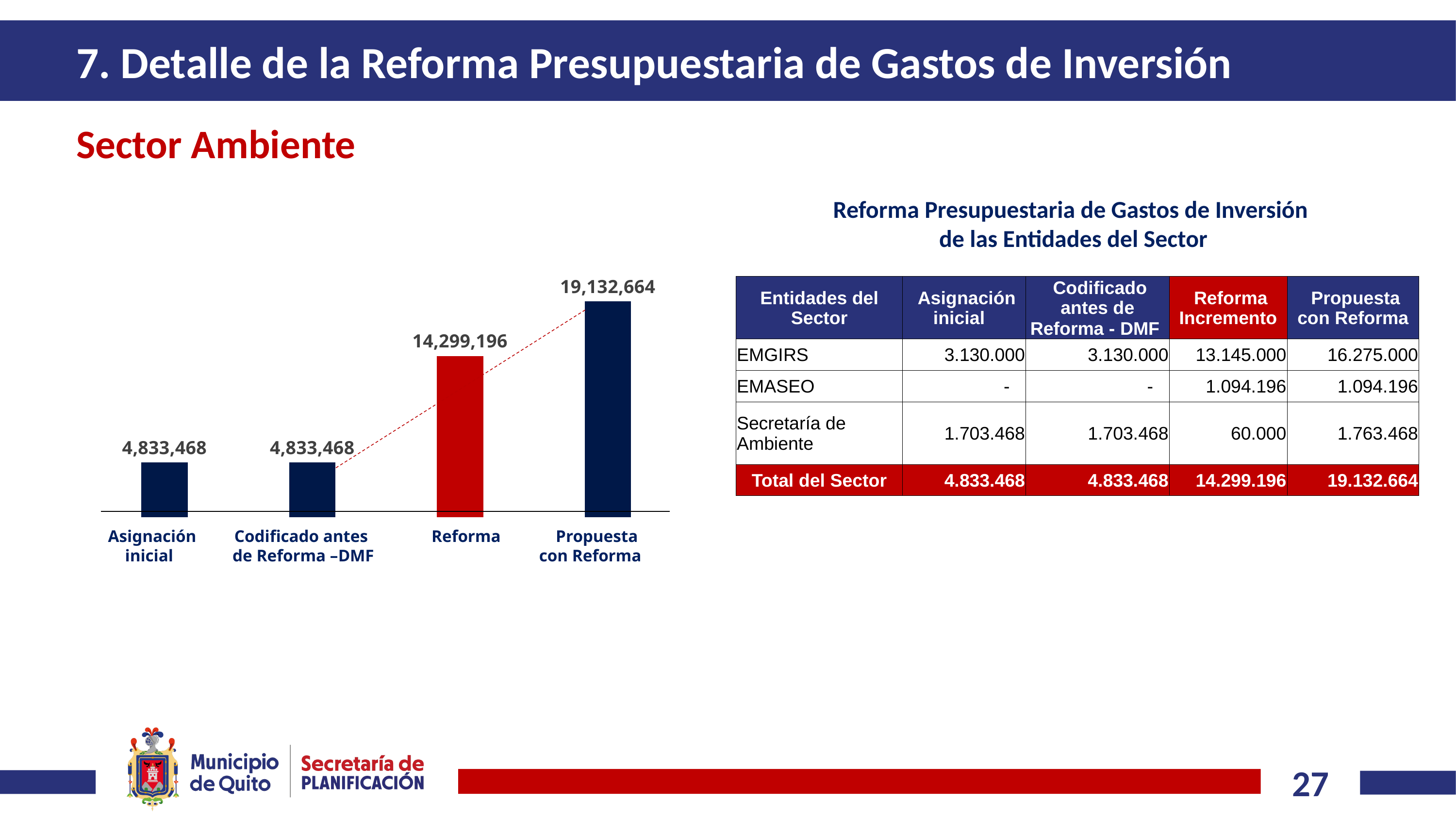
Which category has the highest value in the chart? Propuesta con Reforma What is the value of the Asignación inicial bar in the chart? 4,833,468 What type of chart is shown on the slide? Bar chart How many bars are shown in the chart? 4 What is the value of the Propuesta con Reforma bar in the chart? 19,132,664 What is the difference between the Reforma bar and the Asignación inicial bar? 9,465,728 What is the difference between the Propuesta con Reforma bar and the Reforma bar? 4,833,468 Do the values in the chart rise or fall from left to right? Rise What is the value of the Reforma bar in the chart? 14,299,196 Which is larger in the chart, Reforma or Codificado antes de Reforma –DMF? Reforma Which bar in the chart is coloured red? Reforma What is the value of the Codificado antes de Reforma –DMF bar in the chart? 4,833,468